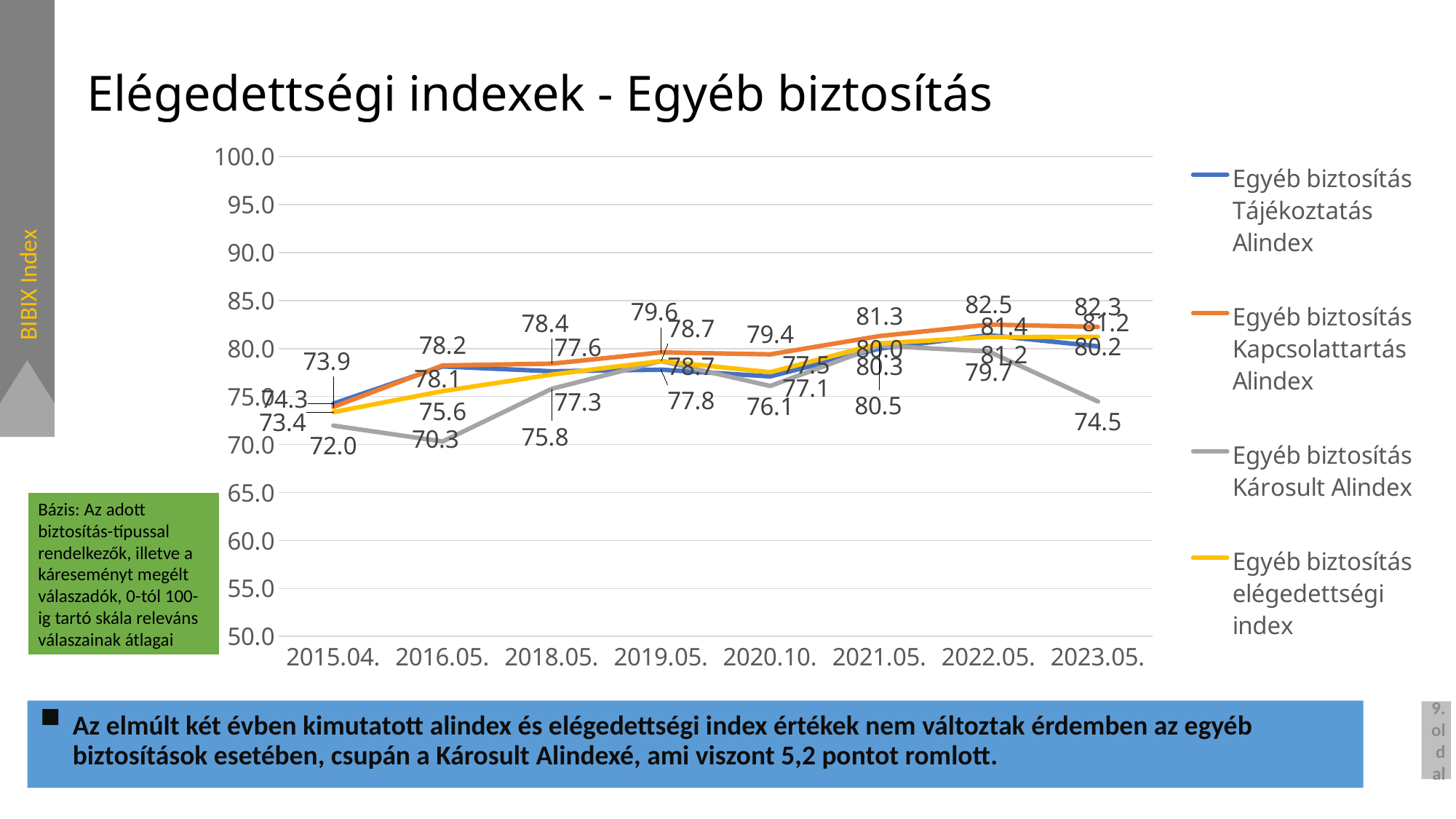
At 2023.05., which is larger: the Kapcsolattartás Alindex or the Károsult Alindex? Kapcsolattartás Alindex What is the value of the Egyéb biztosítás Kapcsolattartás Alindex series at 2019.05.? 79.6 By how much did the Egyéb biztosítás Károsult Alindex fall from 2022.05. (79.7) to 2023.05. (74.5)? 5.2 How many series does the chart legend list? 4 Is the value of the Egyéb biztosítás Károsult Alindex at 2023.05. greater or less than 75.0? less What is the value of the Egyéb biztosítás Károsult Alindex series at 2016.05.? 70.3 How many dates are shown on the x axis of the chart? 8 At which date does the Egyéb biztosítás Kapcsolattartás Alindex series reach its highest value? 2022.05. At which date does the Egyéb biztosítás Károsult Alindex series reach its lowest value? 2016.05. What kind of chart is shown on the slide? line chart What is the value of the Egyéb biztosítás Károsult Alindex series at 2023.05.? 74.5 What is the value of the Egyéb biztosítás Kapcsolattartás Alindex series at 2022.05.? 82.5